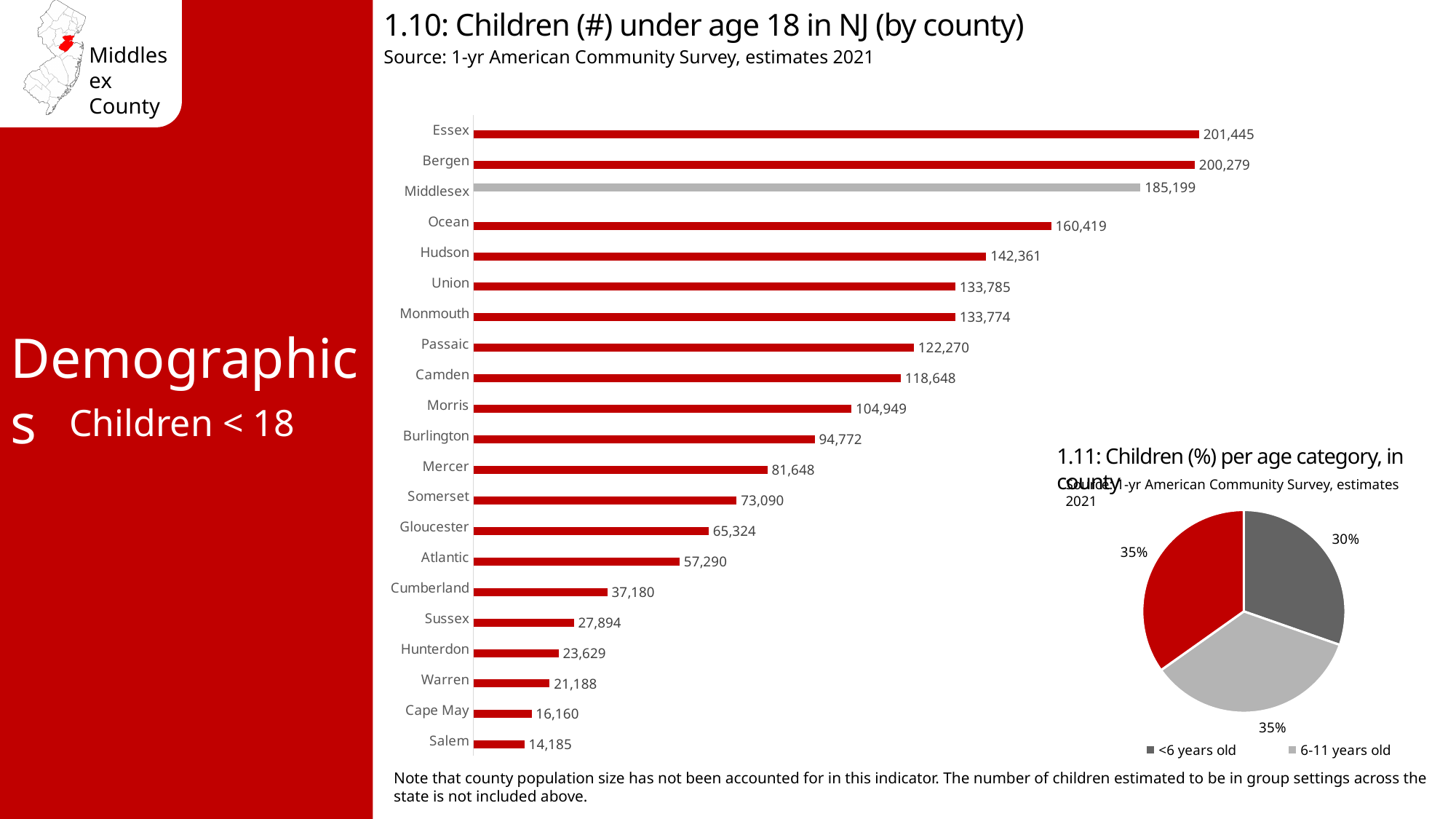
How many counties are shown in the chart '1.10: Children (#) under age 18 in NJ (by county)'? 21 In the chart '1.10: Children (#) under age 18 in NJ (by county)', which county has the lowest value? Salem In the chart '1.10: Children (#) under age 18 in NJ (by county)', what is the value for Middlesex? 185,199 In the chart '1.10: Children (#) under age 18 in NJ (by county)', what is the value for Cape May? 16,160 In the chart '1.10: Children (#) under age 18 in NJ (by county)', which is larger, the value for Hudson or the value for Passaic? Hudson In the chart '1.10: Children (#) under age 18 in NJ (by county)', which bar is shown in a different colour (grey) from the others? Middlesex What kind of chart is '1.11: Children (%) per age category, in county'? Pie chart What kind of chart is '1.10: Children (#) under age 18 in NJ (by county)'? Bar chart In the chart '1.10: Children (#) under age 18 in NJ (by county)', which county has the highest value? Essex In the pie chart '1.11: Children (%) per age category, in county', what share is the '<6 years old' slice? 30% In the chart '1.10: Children (#) under age 18 in NJ (by county)', what is the value for Ocean? 160,419 In the chart '1.10: Children (#) under age 18 in NJ (by county)', what is the difference between the values for Essex and Bergen? 1,166